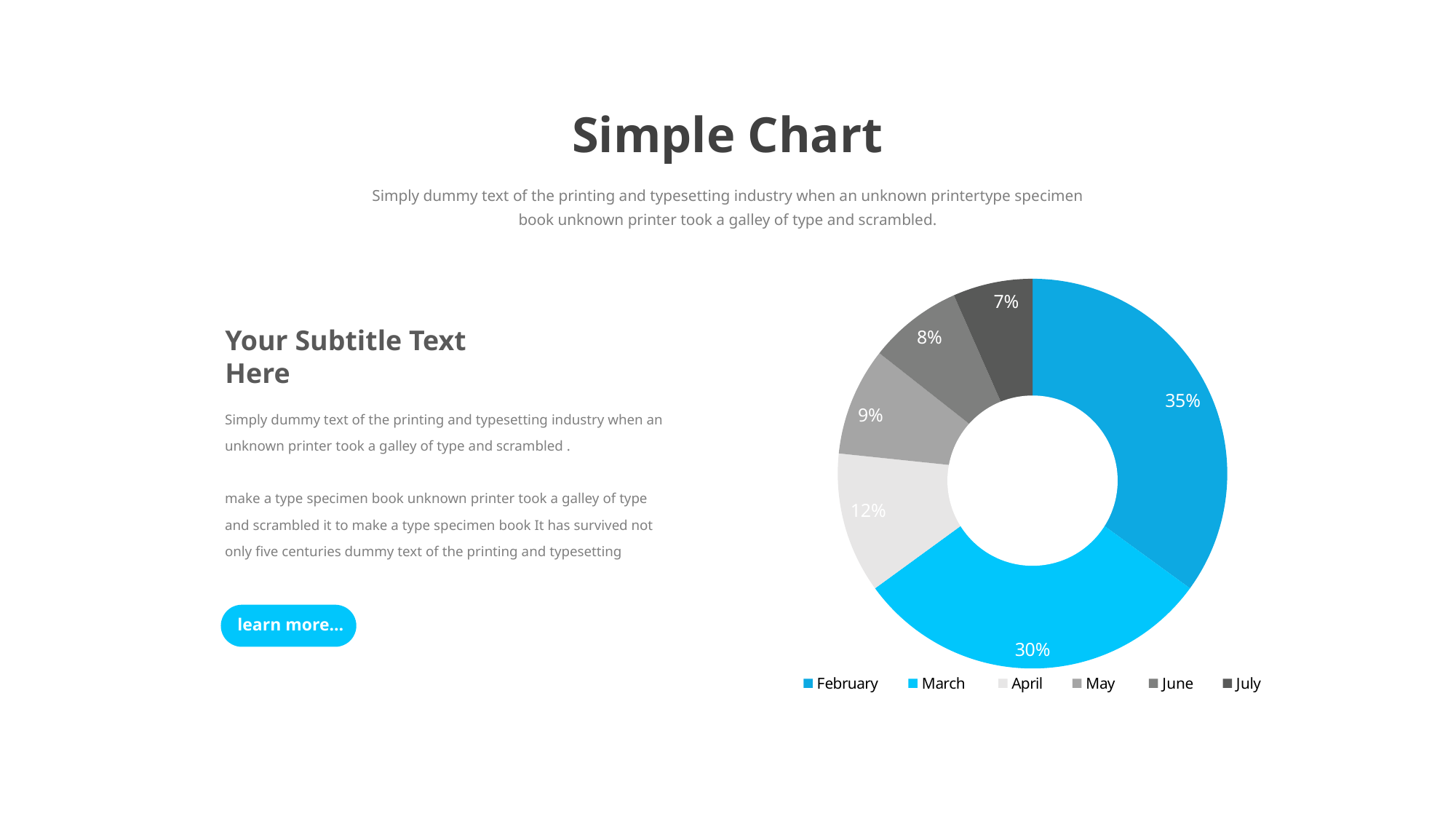
What percentage does the March slice show? 30% What is the title of the slide containing the chart? Simple Chart Which month has the largest slice? February What is the difference between the February and March percentages? 5% What percentage does the July slice show? 7% What kind of chart is shown on the slide? Doughnut chart What percentage does the April slice show? 12% What percentage does the February slice show? 35% What is the combined share of the April and May slices? 21% Which is larger, the May slice or the June slice? May Which month has the smallest slice? July How many slices does the chart have? 6